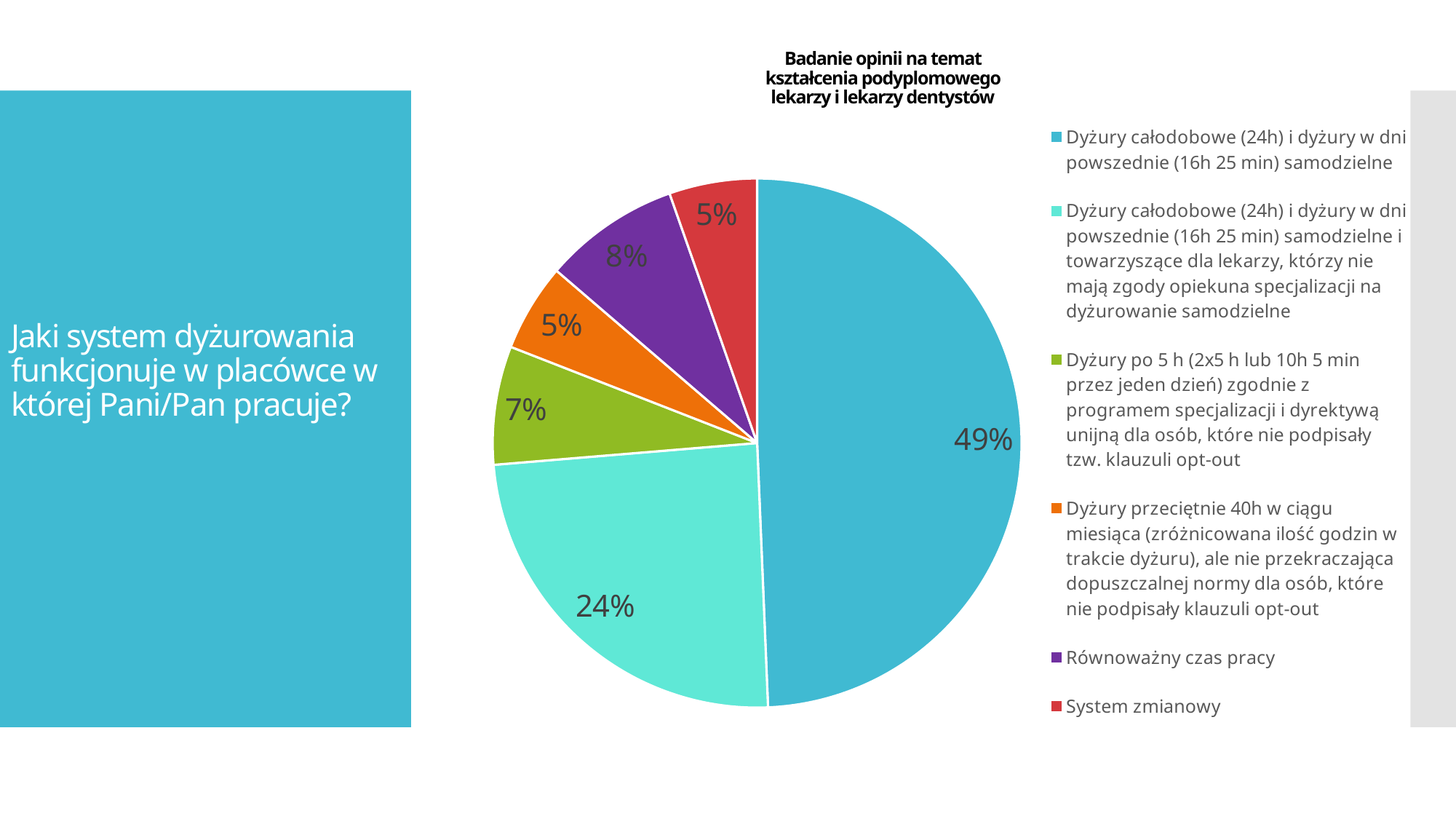
What share of the pie is labelled "System zmianowy"? 5% What is the share of the largest slice? 49% What share of the pie is labelled "Równoważny czas pracy"? 8% Which category has the largest slice of the pie? Dyżury całodobowe (24h) i dyżury w dni powszednie (16h 25 min) samodzielne What is the title of the chart? Badanie opinii na temat kształcenia podyplomowego lekarzy i lekarzy dentystów What kind of chart is shown on the slide? pie chart How many slices does the pie chart have? 6 What percentage is shown for "Dyżury przeciętnie 40h w ciągu miesiąca..."? 5% How many entries does the legend list? 6 What percentage is shown for "Dyżury po 5 h (2x5 h lub 10h 5 min przez jeden dzień)..."? 7% Which is larger: the slice for "Równoważny czas pracy" or the slice for "System zmianowy"? Równoważny czas pracy What is the difference in percentage points between the 49% slice and the 24% slice? 25